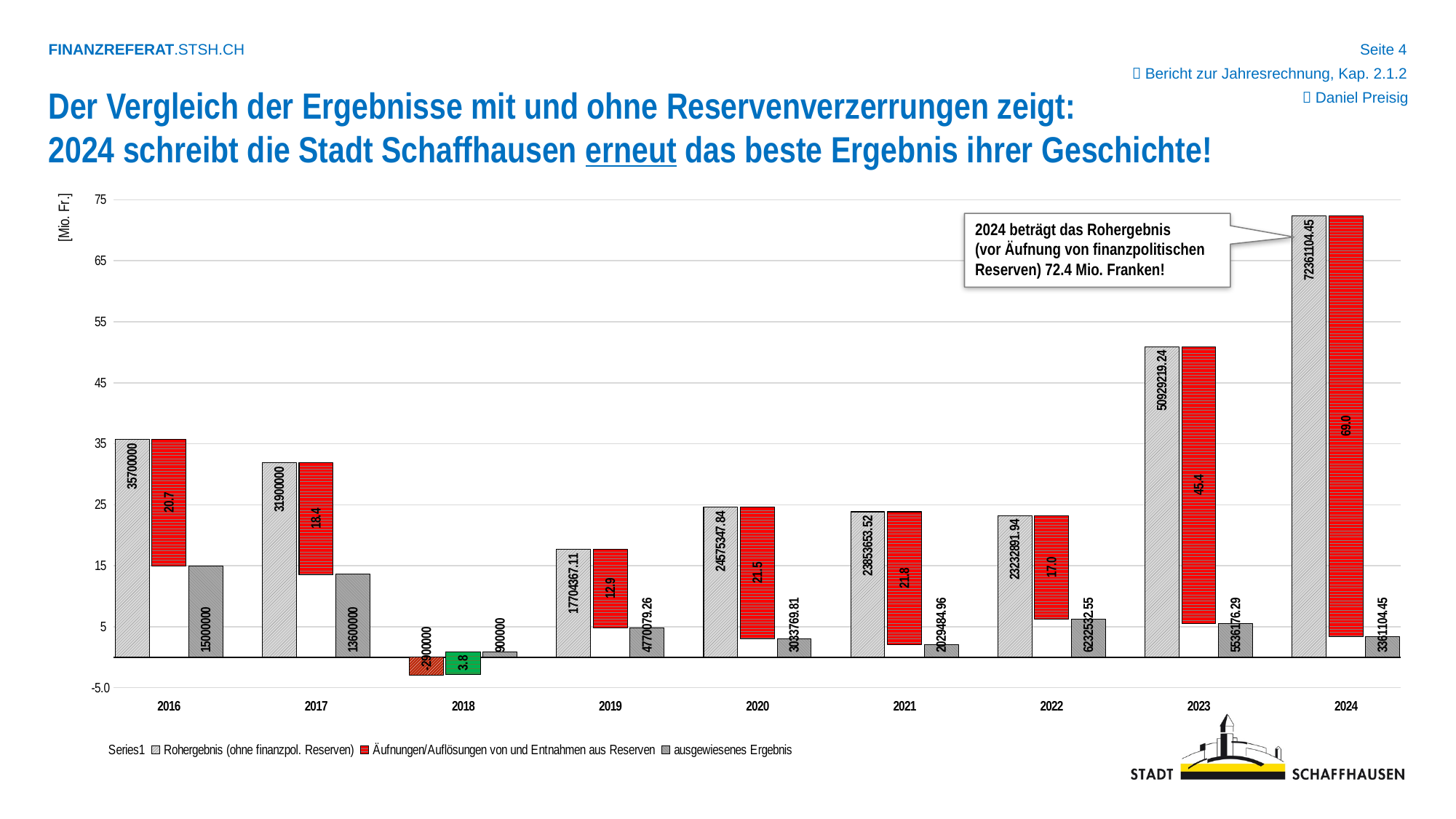
What kind of chart is shown on the slide? bar chart How many years are shown on the x axis of the chart? 9 What is the data label on the Äufnungen/Auflösungen von und Entnahmen aus Reserven bar for 2023? 45.4 What is the difference between the ausgewiesenes Ergebnis for 2016 and for 2017? 1400000 What is the data label on the Rohergebnis (ohne finanzpol. Reserven) bar for 2024? 72361104.45 What is the data label on the Rohergebnis (ohne finanzpol. Reserven) bar for 2018? -2900000 Is the Rohergebnis (ohne finanzpol. Reserven) value for 2023 greater or less than 45? greater In which year is the Rohergebnis (ohne finanzpol. Reserven) bar the highest? 2024 What is the data label on the ausgewiesenes Ergebnis bar for 2016? 15000000 Does the Rohergebnis (ohne finanzpol. Reserven) rise or fall from 2022 to 2024? rise Which year has the larger ausgewiesenes Ergebnis, 2022 or 2023? 2022 In which year is the Rohergebnis (ohne finanzpol. Reserven) bar the lowest? 2018